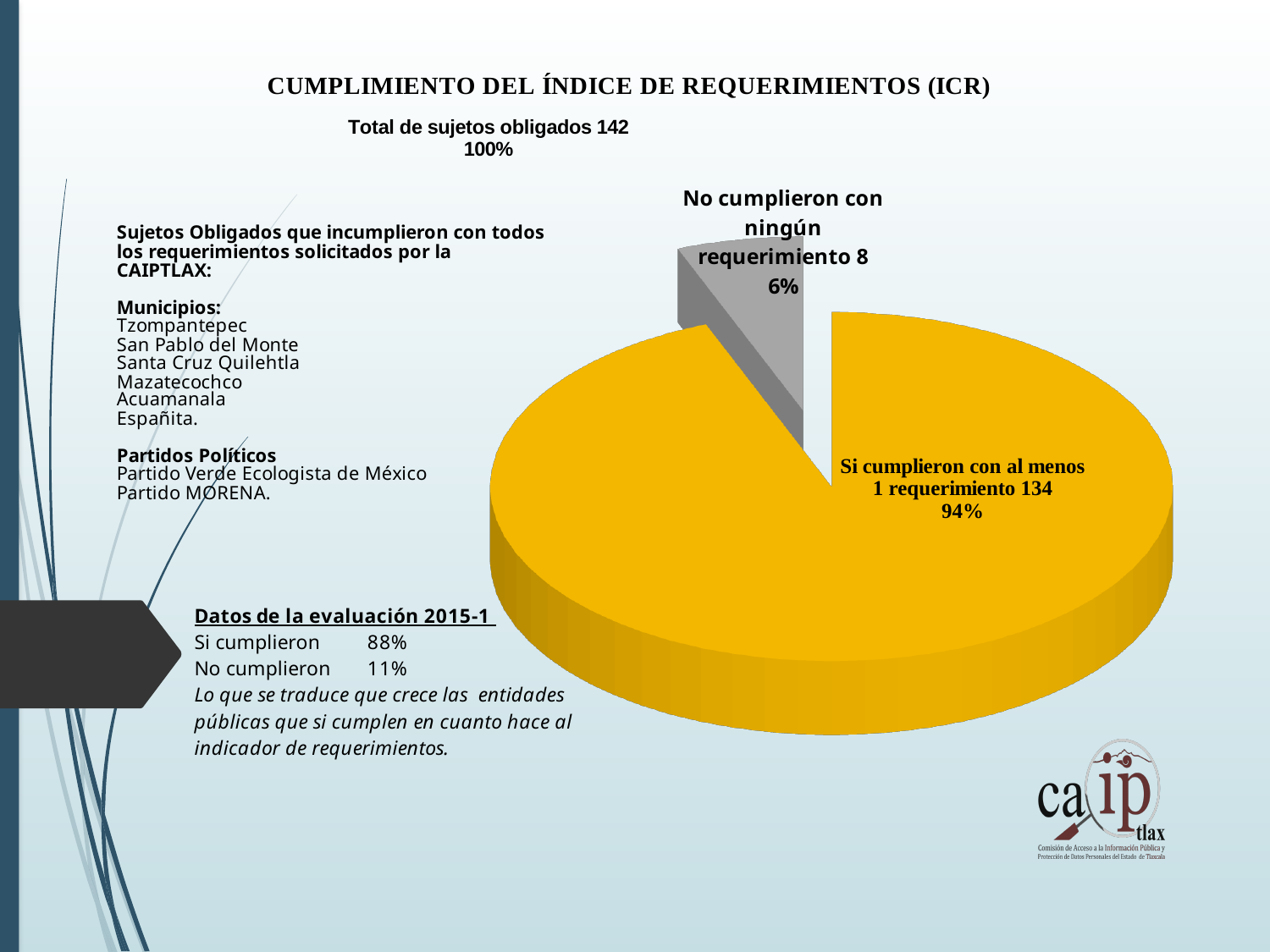
What is the difference in count between the 'Si cumplieron' slice and the 'No cumplieron' slice? 126 What percentage share does the 'Si cumplieron con al menos 1 requerimiento' slice represent? 94% How many subjects are in the 'No cumplieron con ningún requerimiento' slice? 8 Which slice of the pie chart is the smallest? No cumplieron con ningún requerimiento How many subjects are in the 'Si cumplieron con al menos 1 requerimiento' slice? 134 What kind of chart is shown on the slide? pie chart Which slice of the pie chart is the largest? Si cumplieron con al menos 1 requerimiento What percentage share does the 'No cumplieron con ningún requerimiento' slice represent? 6% What colour is the 'No cumplieron con ningún requerimiento' slice? grey Which is larger: the 'Si cumplieron con al menos 1 requerimiento' slice or the 'No cumplieron con ningún requerimiento' slice? Si cumplieron con al menos 1 requerimiento What is the total number of obligated subjects shown above the pie chart? 142 How many slices does the pie chart have? 2